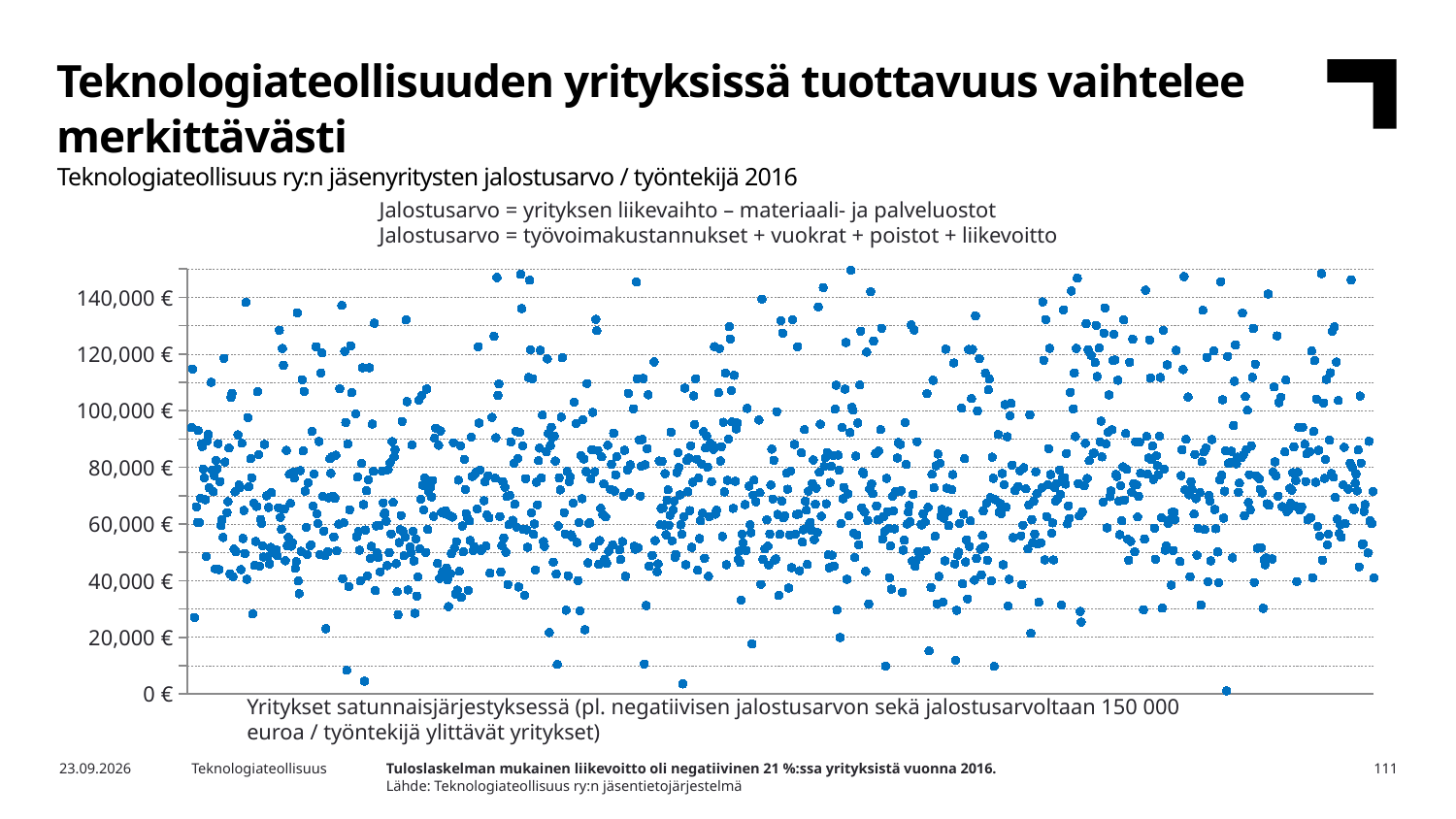
What is the highest value labelled on the vertical axis of the chart? 140,000 € What kind of chart is shown on the slide? scatter chart Which year's value added per employee does the chart show? 2016 What is the lowest value labelled on the vertical axis of the chart? 0 €